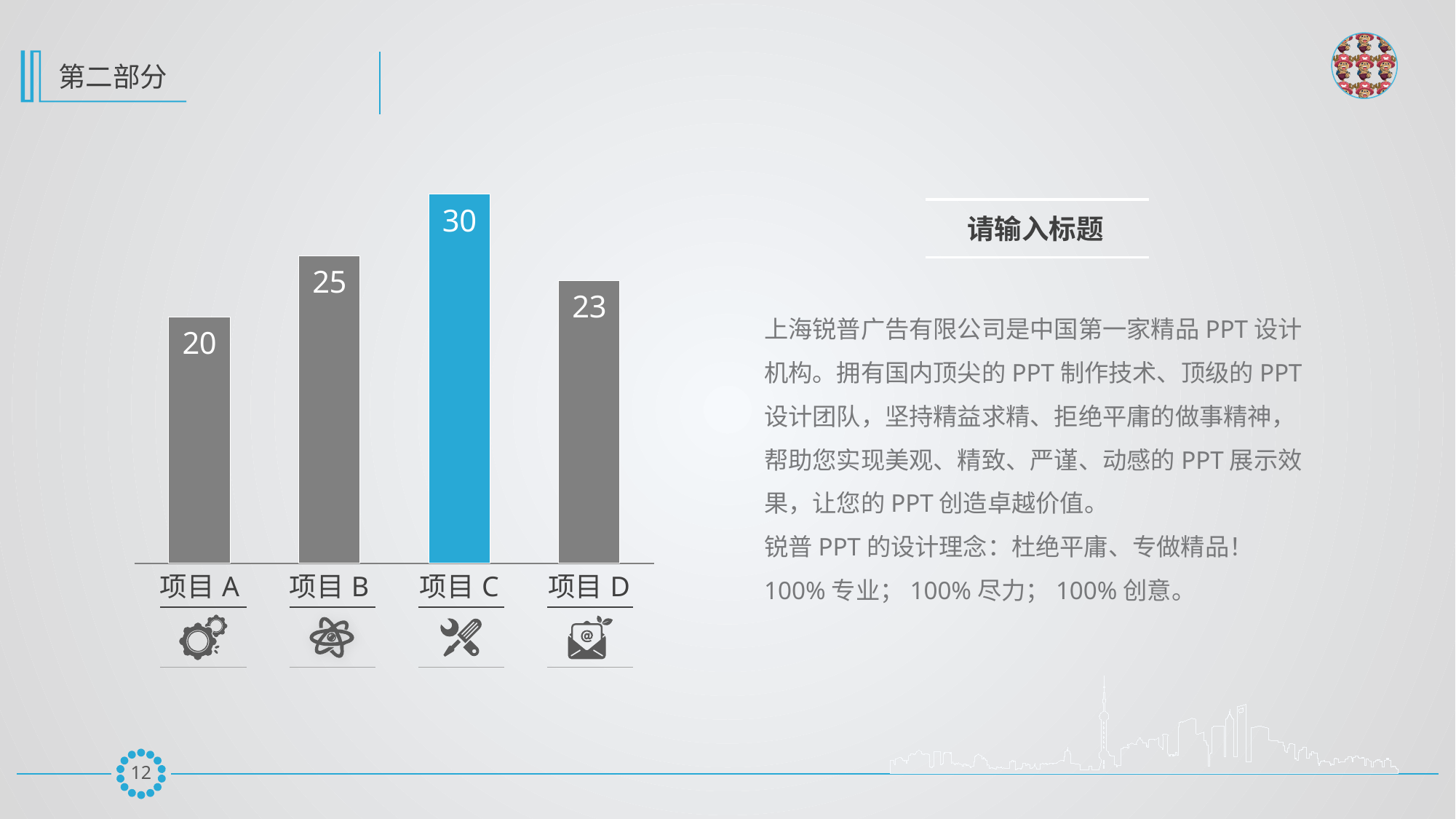
What is the value for 项目 D? 23 Which is larger, the value for 项目 B or the value for 项目 D? 项目 B What is the difference between the values for 项目 B and 项目 D? 2 What is the value for 项目 B? 25 What is the value for 项目 C? 30 Which bar is coloured blue rather than grey? 项目 C What is the value for 项目 A? 20 What kind of chart is shown on the slide? bar chart Which category has the highest value? 项目 C Which category has the lowest value? 项目 A What is the difference between the values for 项目 C and 项目 A? 10 How many categories are shown in the chart? 4